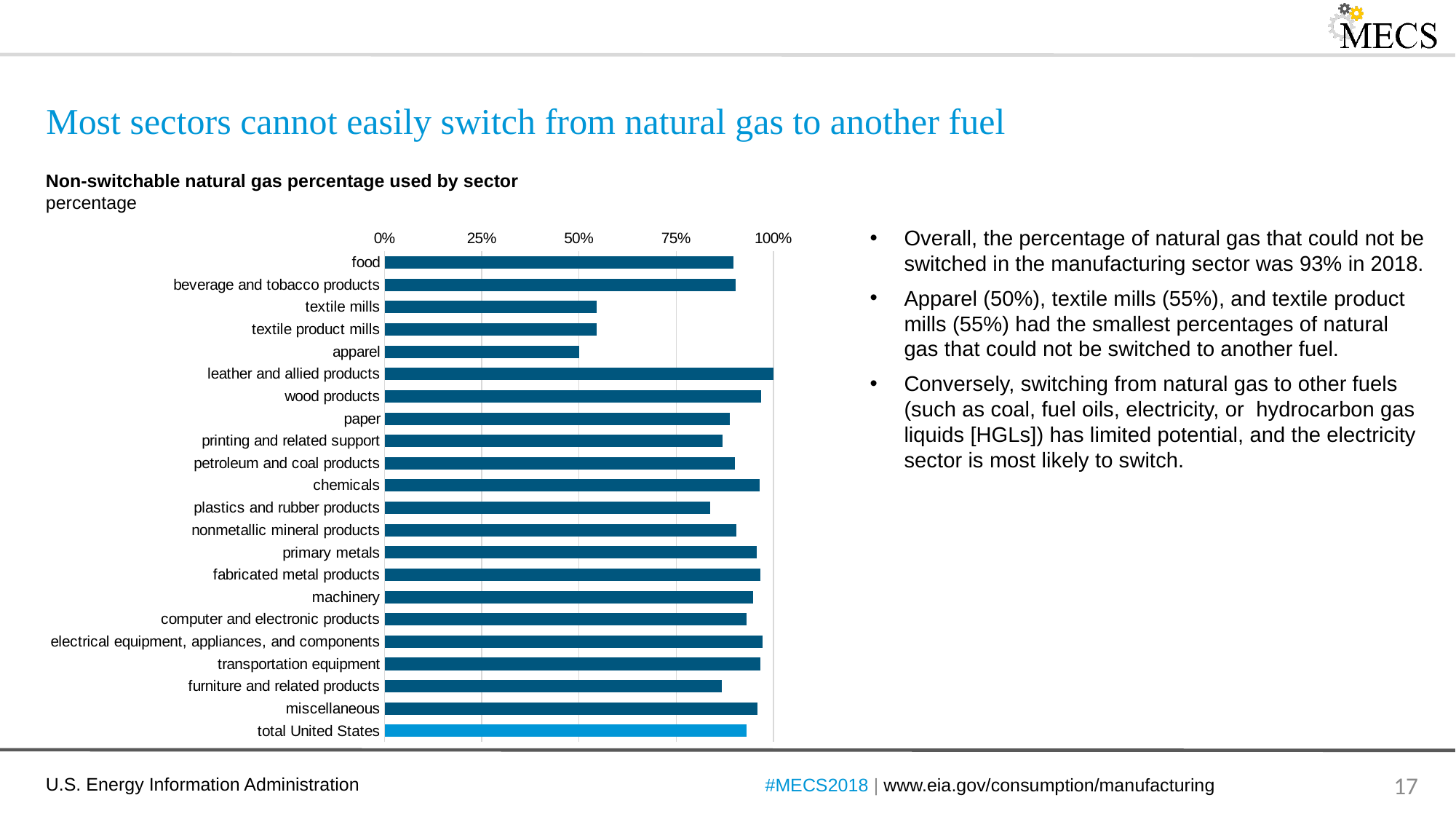
What is the non-switchable natural gas percentage for total United States? 93% Which sector has the lowest non-switchable natural gas percentage? apparel What kind of chart is shown on the slide? bar chart Which has a larger value, chemicals or plastics and rubber products? chemicals What is the non-switchable natural gas percentage for apparel? 50% What is the title of the chart? Non-switchable natural gas percentage used by sector Is the value for plastics and rubber products greater or less than 75%? greater Is the value for food greater or less than 75%? greater How many sectors (bars) are plotted in the chart? 22 Which sector has the highest non-switchable natural gas percentage? leather and allied products Which bar is drawn in a different, lighter blue colour than the others? total United States Is the value for textile mills greater or less than 50%? greater